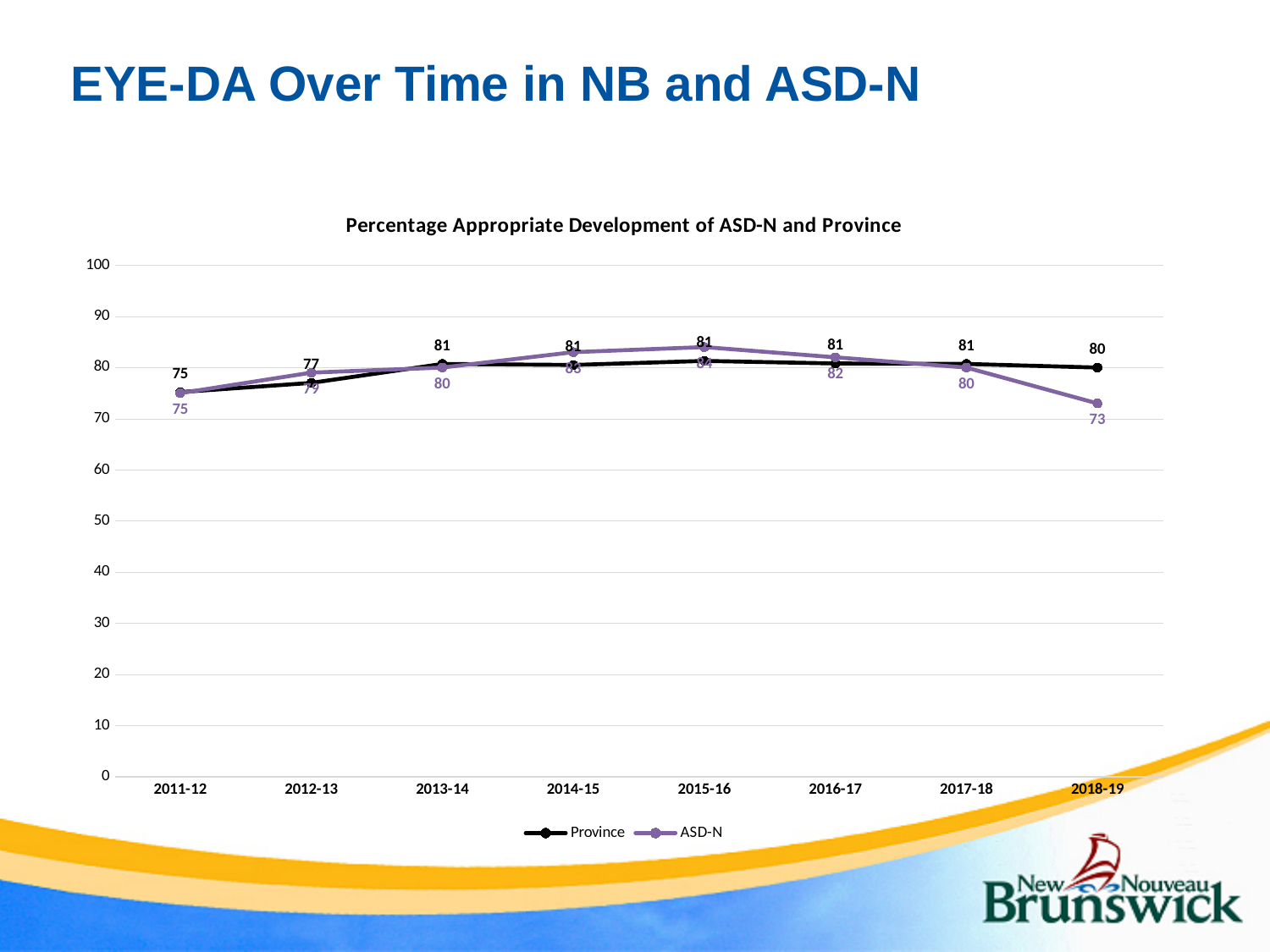
What is the difference between the Province and ASD-N values in 2018-19? 7 Does the ASD-N line rise or fall from 2016-17 to 2018-19? Fall How many series does the legend list? 2 What is the Province value for 2011-12? 75 How many years are shown on the x axis? 8 Is the ASD-N value for 2018-19 greater or less than 80? less What kind of chart is shown on the slide? Line chart What is the ASD-N value for 2018-19? 73 What is the ASD-N value for 2016-17? 82 What is the Province value for 2018-19? 80 In which year is the ASD-N value lowest? 2018-19 In 2012-13, which series has the higher value, Province or ASD-N? ASD-N